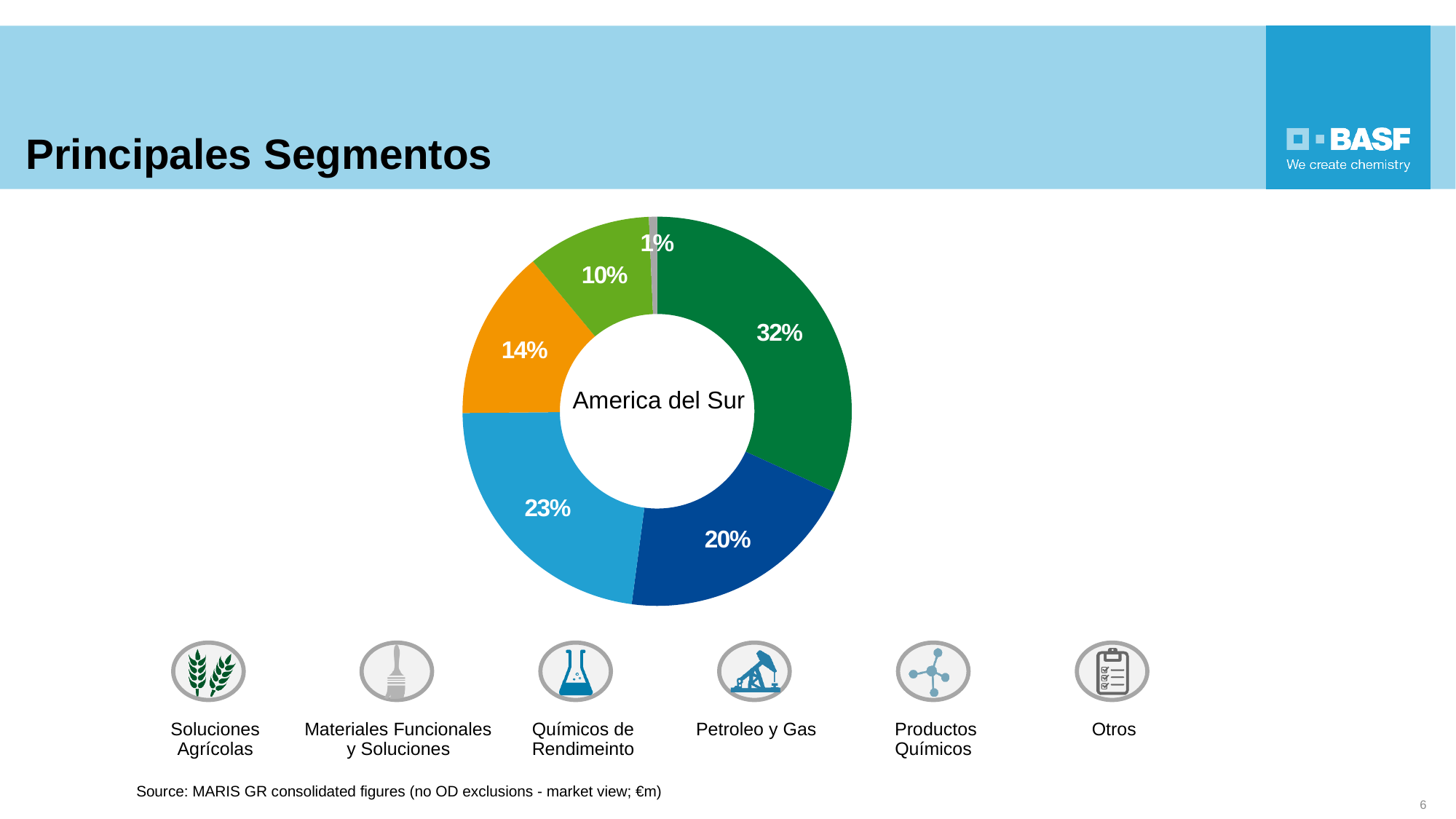
What is the difference in percentage points between the dark green slice (32%) and the dark blue slice (20%)? 12 percentage points What is the smallest percentage shown on the donut chart? 1% What text is written in the centre of the donut chart? America del Sur What percentage is shown on the dark green slice of the donut chart? 32% How many slices does the donut chart have? 6 What percentage is shown on the dark blue slice of the donut chart? 20% What kind of chart is shown on the slide? pie chart (donut) What percentage is shown on the orange slice of the donut chart? 14% Which slice is larger, the light blue slice or the dark blue slice? the light blue slice (23%) What is the largest percentage shown on the donut chart? 32% What percentage is shown on the light green slice of the donut chart? 10% What percentage is shown on the light blue slice of the donut chart? 23%